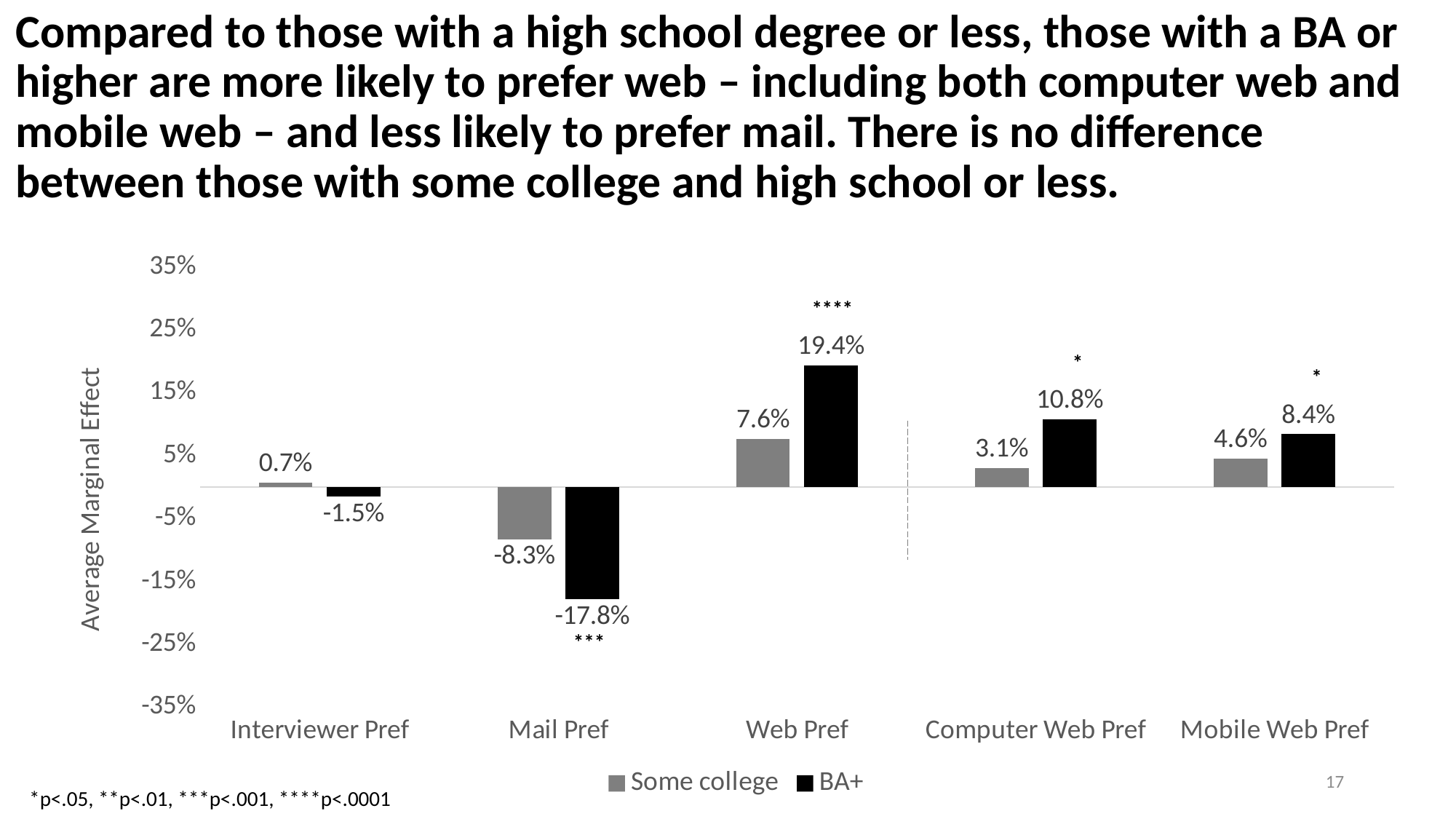
Which category has the highest value for the BA+ series? Web Pref Which category has the lowest value for the Some college series? Mail Pref How many categories are shown on the x axis? 5 What is the value for Some college on Mobile Web Pref? 4.6% What is the value for BA+ on Interviewer Pref? -1.5% What is the label of the vertical axis? Average Marginal Effect Which is larger for Mail Pref: the Some college value or the BA+ value? Some college How many series does the legend list? 2 What is the average marginal effect for BA+ on Web Pref? 19.4% What kind of chart is shown on the slide? Bar chart What is the average marginal effect for Some college on Mail Pref? -8.3% What is the difference between the BA+ and Some college values for Computer Web Pref? 7.7%